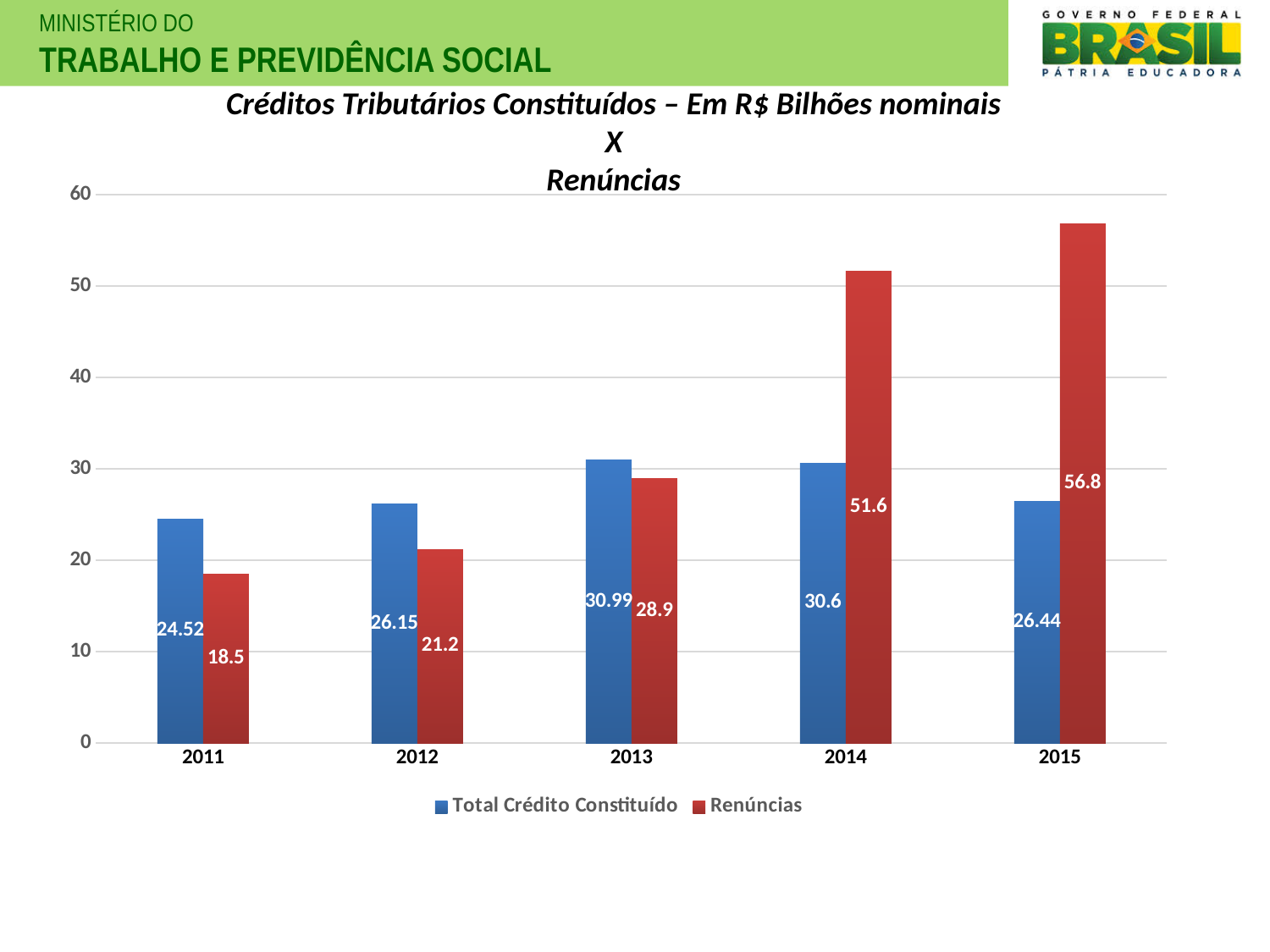
In which year is Renúncias lowest? 2011 How many years are shown on the x axis? 5 In which year is Renúncias highest? 2015 In which year is Total Crédito Constituído highest? 2013 What kind of chart is shown on the slide? Bar chart Is the value of Renúncias for 2014 greater or less than 50? greater What is the value of Renúncias for 2015? 56.8 How many series does the legend list? 2 What is the value of Total Crédito Constituído for 2011? 24.52 What is the difference between Renúncias and Total Crédito Constituído in 2014? 21 What is the value of Renúncias for 2013? 28.9 Which is larger in 2012, Total Crédito Constituído or Renúncias? Total Crédito Constituído